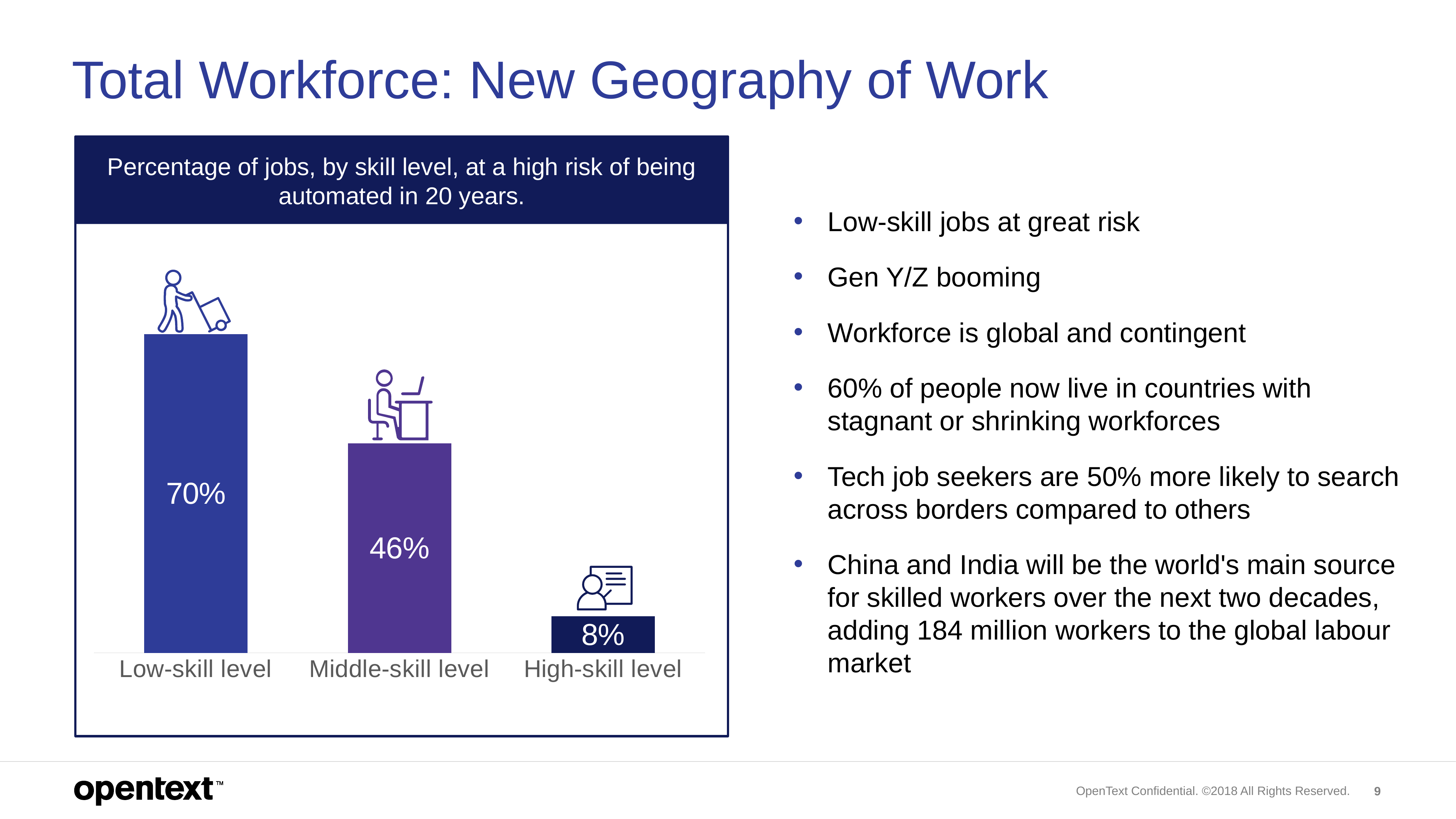
Which is larger, the value for middle-skill level or the value for high-skill level? Middle-skill level Which skill level has the highest percentage of jobs at high risk of automation? Low-skill level What percentage of middle-skill level jobs are at high risk of being automated in 20 years? 46% What kind of chart is shown on the slide? Bar chart What is the difference in percentage points between the middle-skill level and high-skill level bars? 38 What percentage of high-skill level jobs are at high risk of being automated in 20 years? 8% What is the difference in percentage points between the low-skill level and middle-skill level bars? 24 What percentage of low-skill level jobs are at high risk of being automated in 20 years? 70% Do the values rise or fall moving from low-skill level to high-skill level along the x axis? Fall Which skill level has the lowest percentage of jobs at high risk of automation? High-skill level How many skill-level categories are shown in the chart? 3 What is the title of the chart? Percentage of jobs, by skill level, at a high risk of being automated in 20 years.